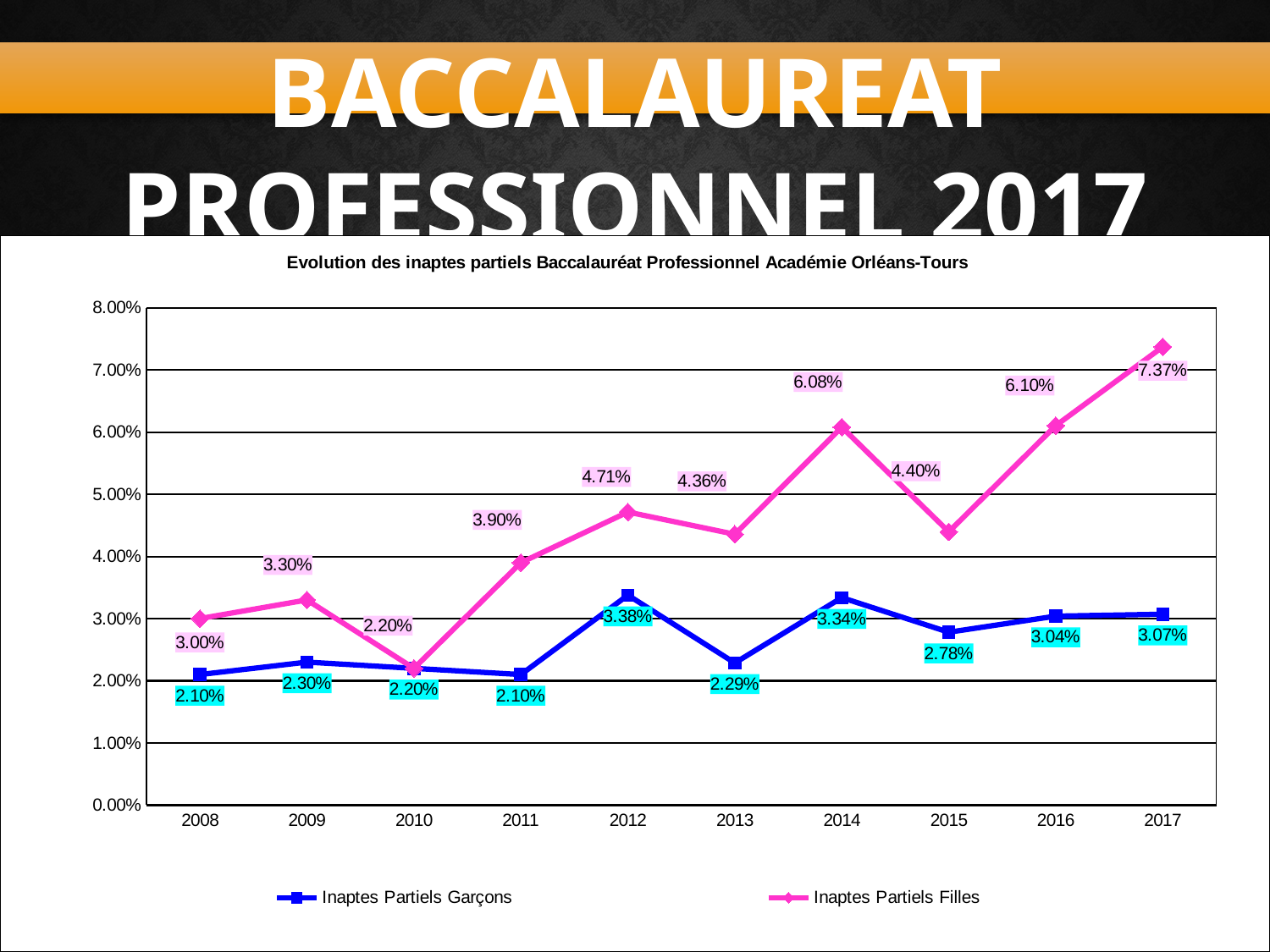
What is the title of the chart? Evolution des inaptes partiels Baccalauréat Professionnel Académie Orléans-Tours What is the value for Inaptes Partiels Filles in 2017? 7.37% What is the value for Inaptes Partiels Garçons in 2012? 3.38% Which series has the larger value in 2015, Inaptes Partiels Garçons or Inaptes Partiels Filles? Inaptes Partiels Filles What is the value for Inaptes Partiels Filles in 2014? 6.08% Does the Inaptes Partiels Filles value rise or fall from 2014 to 2015? Fall What is the difference between the Inaptes Partiels Filles and Inaptes Partiels Garçons values in 2017? 4.30% What type of chart is shown on the slide? Line chart How many series does the legend list? 2 In which year is the Inaptes Partiels Filles value highest? 2017 In which year is the Inaptes Partiels Filles value lowest? 2010 How many years are shown on the x axis? 10